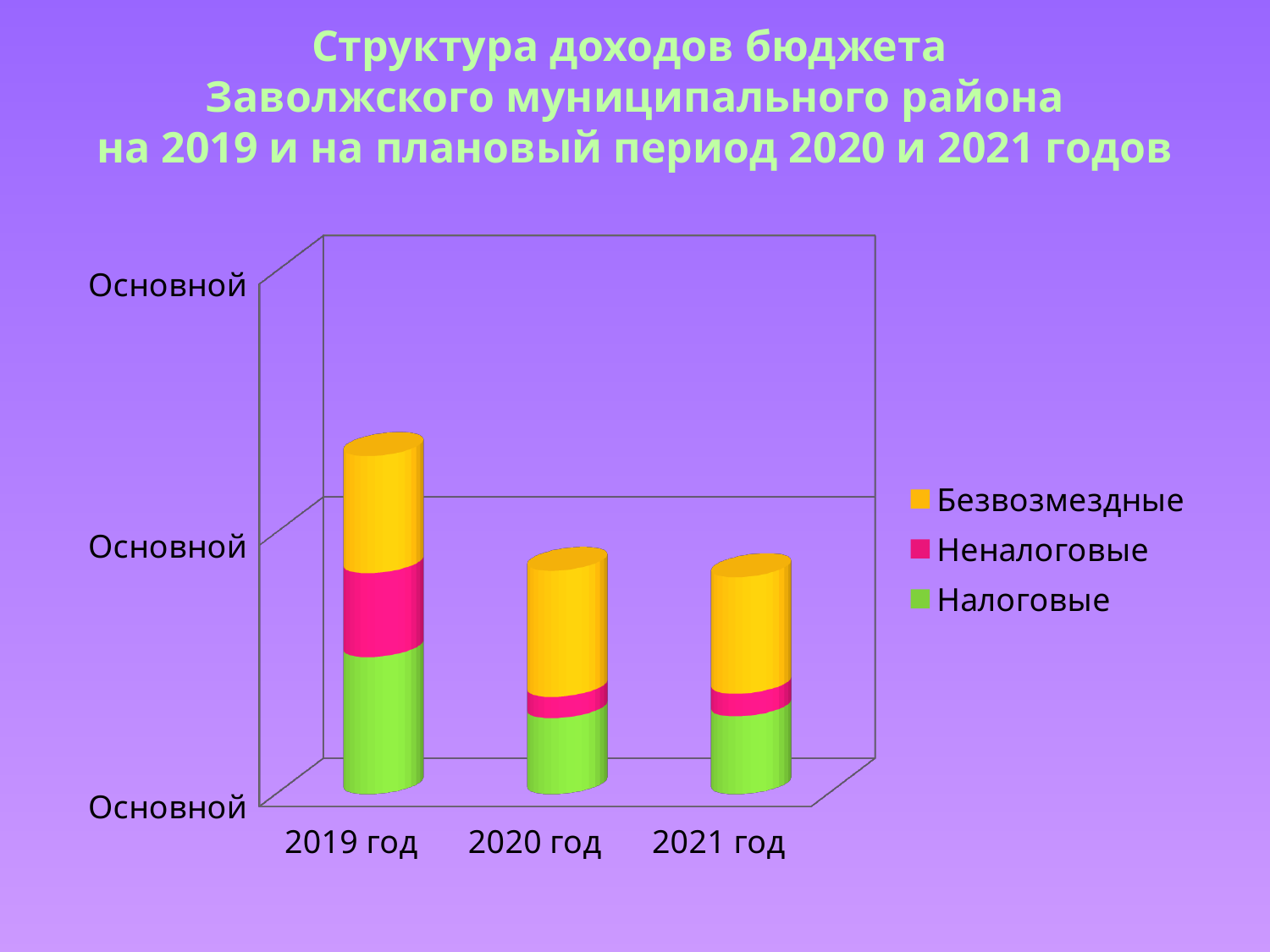
Which series is shown in yellow? Безвозмездные Which is larger, the total bar for 2019 год or for 2020 год? 2019 год Which series is the smallest segment of the 2021 год bar? Неналоговые Which year has the tallest stacked bar? 2019 год What kind of chart is shown on the slide? Stacked bar chart Which series is the largest segment of the 2020 год bar? Безвозмездные Which series is the smallest segment of the 2020 год bar? Неналоговые How many series does the legend list? 3 How many years (categories) are shown on the x axis? 3 Which series is shown in green? Налоговые Does the total bar height rise or fall from 2019 год to 2020 год? Fall